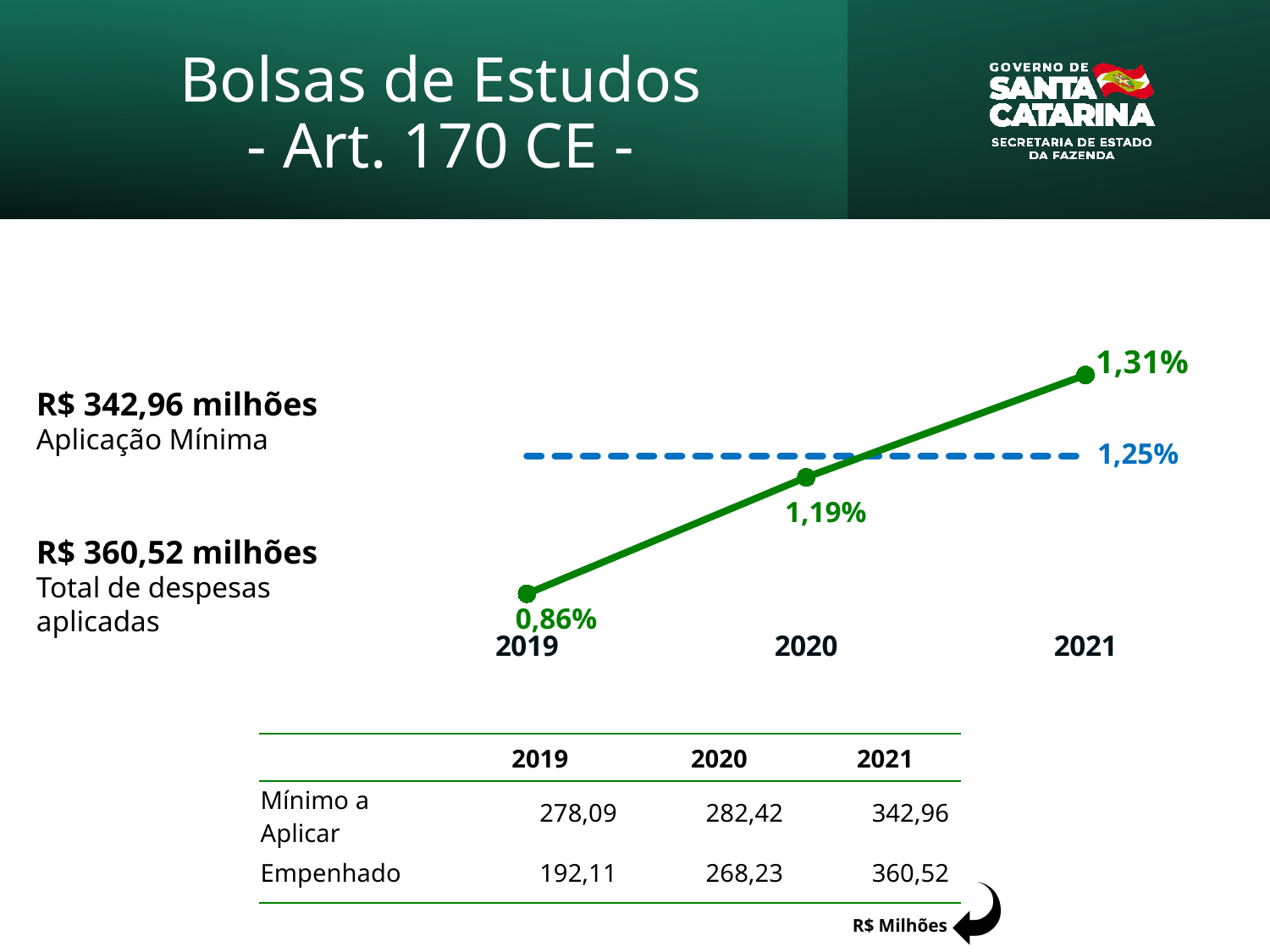
Which year has the lowest value on the line chart? 2019 What value does the dashed blue reference line on the chart mark? 1,25% Is the 2020 value on the line chart larger or smaller than the dashed reference line value of 1,25%? smaller What is the difference between the 2020 value and the 2019 value on the line chart? 0,33% What is the value plotted for 2019 on the line chart? 0,86% What is the value plotted for 2021 on the line chart? 1,31% What kind of chart is shown on the slide? line chart How many years are plotted on the line chart? 3 What is the value plotted for 2020 on the line chart? 1,19% Which year has the highest value on the line chart? 2021 Do the values on the line chart rise or fall from 2019 to 2021? rise What is the difference between the 2021 value and the 2019 value on the line chart? 0,45%